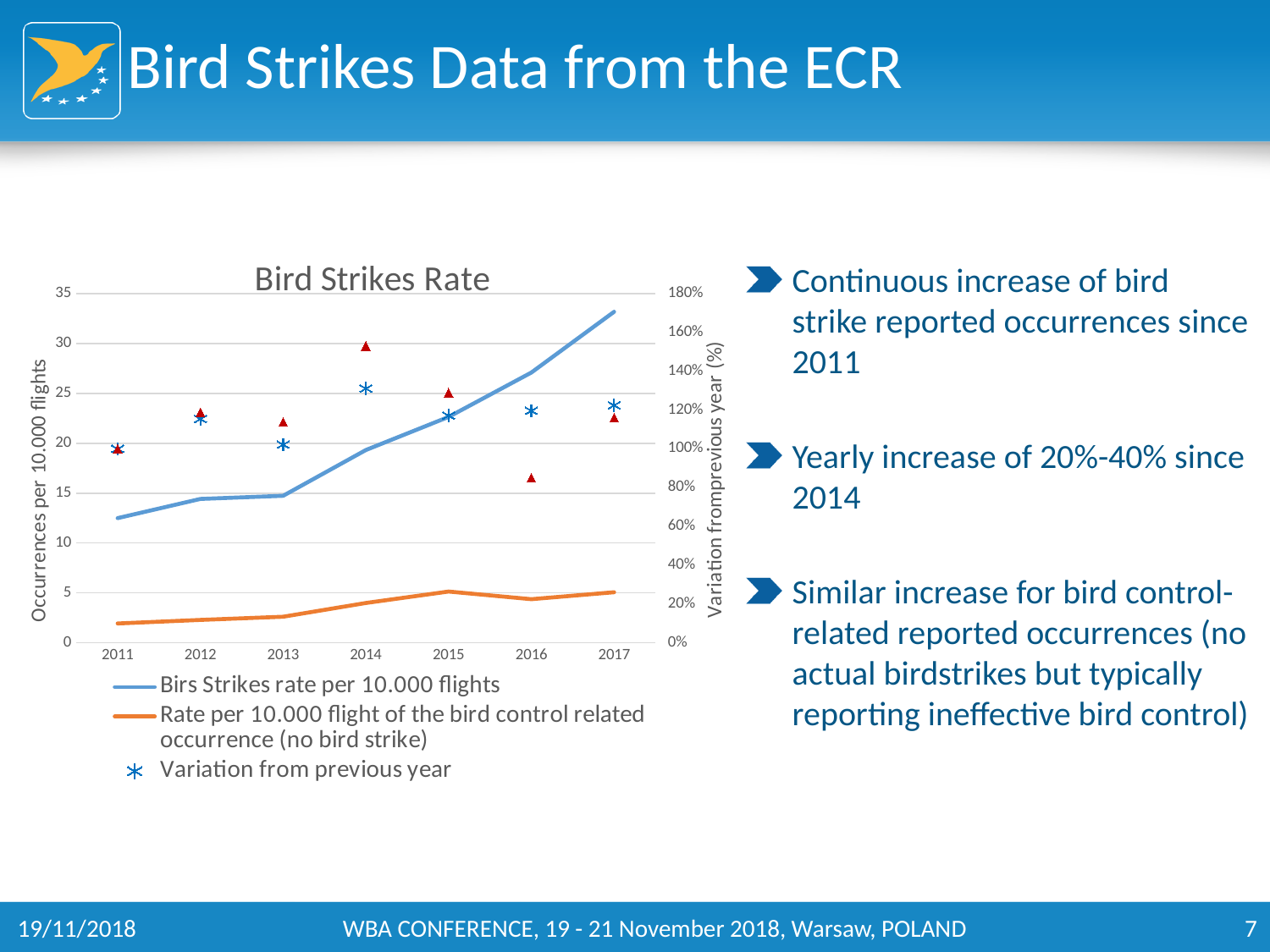
In which year is the Birs Strikes rate per 10.000 flights lowest? 2011 Is the Birs Strikes rate per 10.000 flights in 2017 greater or less than 30? greater How many series does the chart legend list? 3 Is the Birs Strikes rate per 10.000 flights in 2016 greater or less than 25? greater Is the Rate per 10.000 flight of the bird control related occurrence in 2011 greater or less than 5? less How many years are shown on the x axis of the chart? 7 Does the Birs Strikes rate per 10.000 flights rise or fall from 2011 to 2017? rise What is the title of the chart? Bird Strikes Rate What kind of chart is shown on the slide? line chart In which year is the Birs Strikes rate per 10.000 flights highest? 2017 In 2015, which is larger: the Birs Strikes rate per 10.000 flights or the Rate per 10.000 flight of the bird control related occurrence? Birs Strikes rate per 10.000 flights